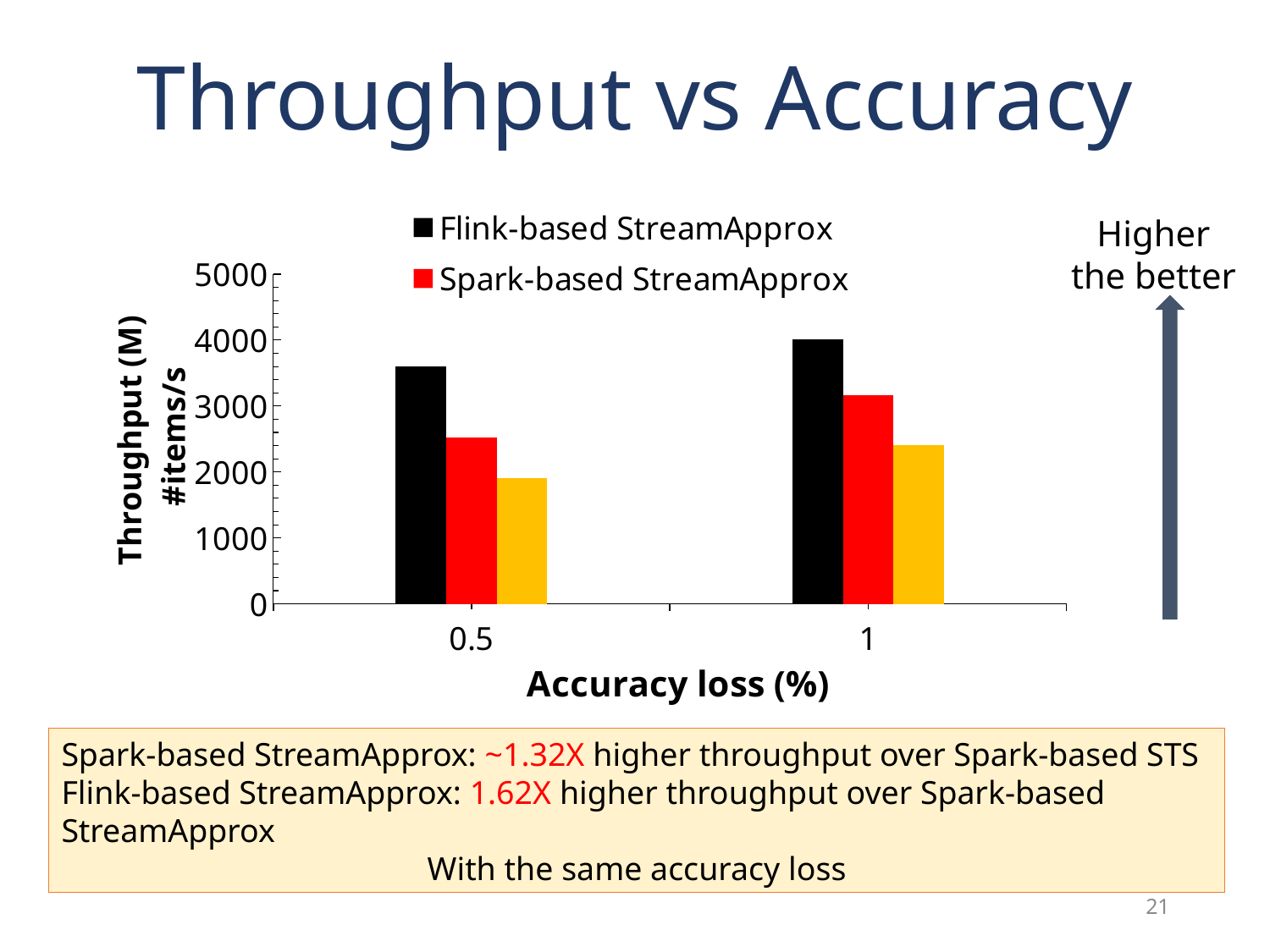
Which series has the higher throughput at 1% accuracy loss, Flink-based StreamApprox or Spark-based StreamApprox? Flink-based StreamApprox Is the throughput of Spark-based StreamApprox at 0.5% accuracy loss greater or less than 3000? less What kind of chart is shown on the slide? bar chart What is the label of the y axis? Throughput (M) #items/s Does the throughput of Flink-based StreamApprox rise or fall as accuracy loss increases from 0.5% to 1%? rise Which bar in the chart is the tallest overall? Flink-based StreamApprox at 1% accuracy loss Is the throughput of Flink-based StreamApprox at 0.5% accuracy loss greater or less than 3000? greater Is the throughput of Spark-based StreamApprox at 1% accuracy loss greater or less than 3000? greater What colour represents Spark-based StreamApprox in the legend? red How many accuracy-loss categories are shown on the x axis? 2 How many series does the chart's legend list? 2